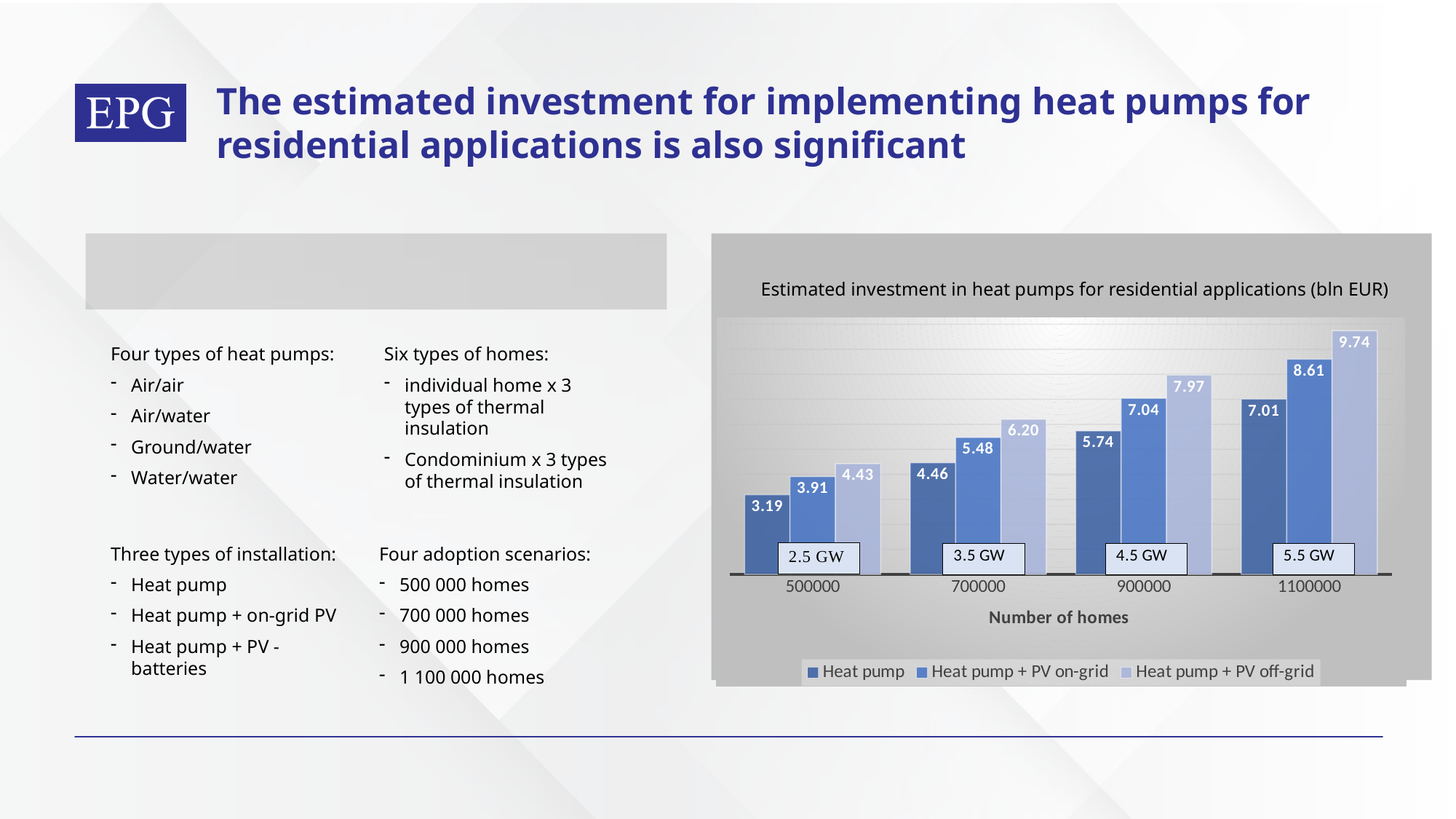
What is the estimated investment for Heat pump + PV off-grid at 1100000 homes? 9.74 Do the Heat pump + PV on-grid values rise or fall as the number of homes increases? Rise How many series does the legend list? 3 Which number of homes has the lowest value for the Heat pump series? 500000 What is the difference between the Heat pump + PV off-grid and Heat pump values at 900000 homes? 2.23 What is the estimated investment for the Heat pump series at 500000 homes? 3.19 What is the estimated investment for Heat pump + PV on-grid at 700000 homes? 5.48 Which is larger at 700000 homes: Heat pump + PV on-grid or Heat pump + PV off-grid? Heat pump + PV off-grid What is the title of the chart? Estimated investment in heat pumps for residential applications (bln EUR) Which number of homes has the highest value for the Heat pump + PV off-grid series? 1100000 How many number-of-homes categories are shown on the x axis? 4 What kind of chart is shown on the slide? Bar chart